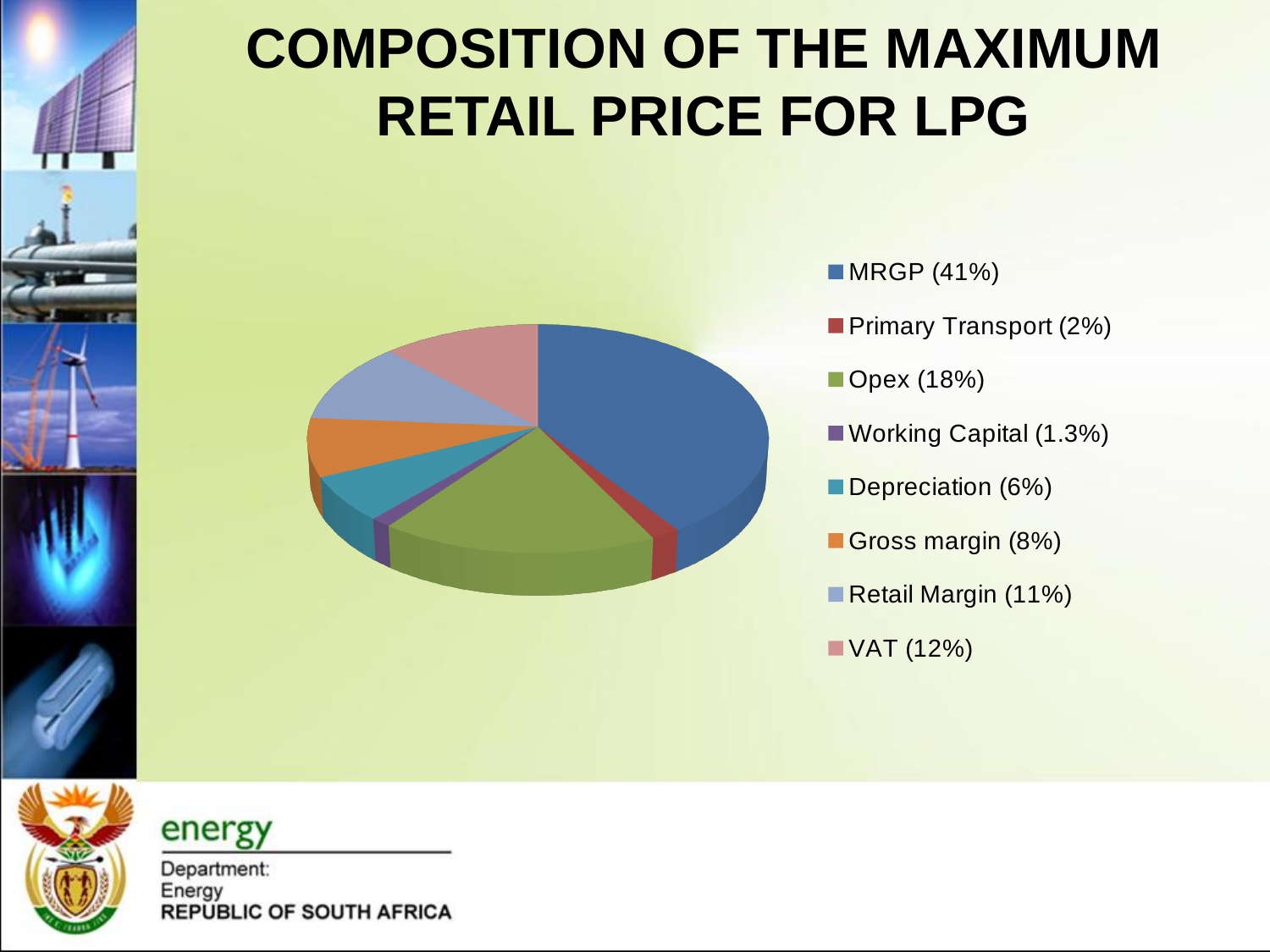
How many components are shown in the pie chart? 8 What is the difference in percentage points between the MRGP share and the VAT share? 29 Which component makes up the largest share of the maximum retail price for LPG? MRGP What kind of chart is shown on the slide? Pie chart Which is larger, the Gross margin share or the Depreciation share? Gross margin What share of the maximum retail price for LPG is Opex? 18% What is the title of the chart on the slide? COMPOSITION OF THE MAXIMUM RETAIL PRICE FOR LPG What share of the maximum retail price for LPG is VAT? 12% What share of the maximum retail price for LPG is Working Capital? 1.3% What is the difference in percentage points between the Opex share and the Retail Margin share? 7 Which component makes up the smallest share of the maximum retail price for LPG? Working Capital